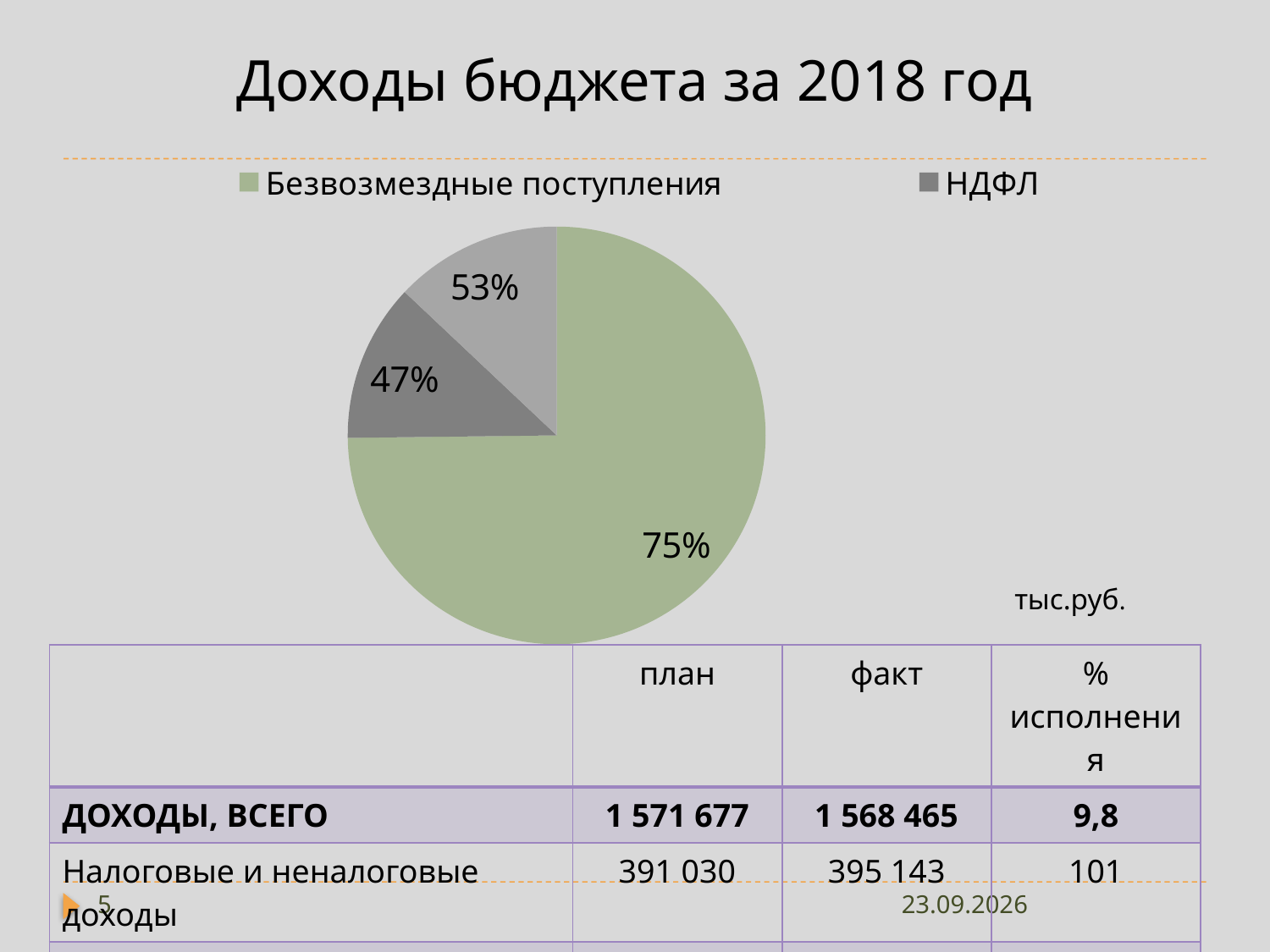
What kind of chart is shown on the slide? pie chart What percentage label is shown on the slice for Безвозмездные поступления? 75% How many slices does the pie chart have? 3 What is the difference in percentage points between the labels for Безвозмездные поступления and НДФЛ? 28 What percentage label is shown on the slice for НДФЛ? 47% What is the title of the chart on the slide? Доходы бюджета за 2018 год Which slice is larger: Безвозмездные поступления or НДФЛ? Безвозмездные поступления Which legend category has the largest slice of the pie? Безвозмездные поступления What share of the pie is labelled for Безвозмездные поступления? 75% How many entries does the chart legend list? 2 What colour is the slice for Безвозмездные поступления? green